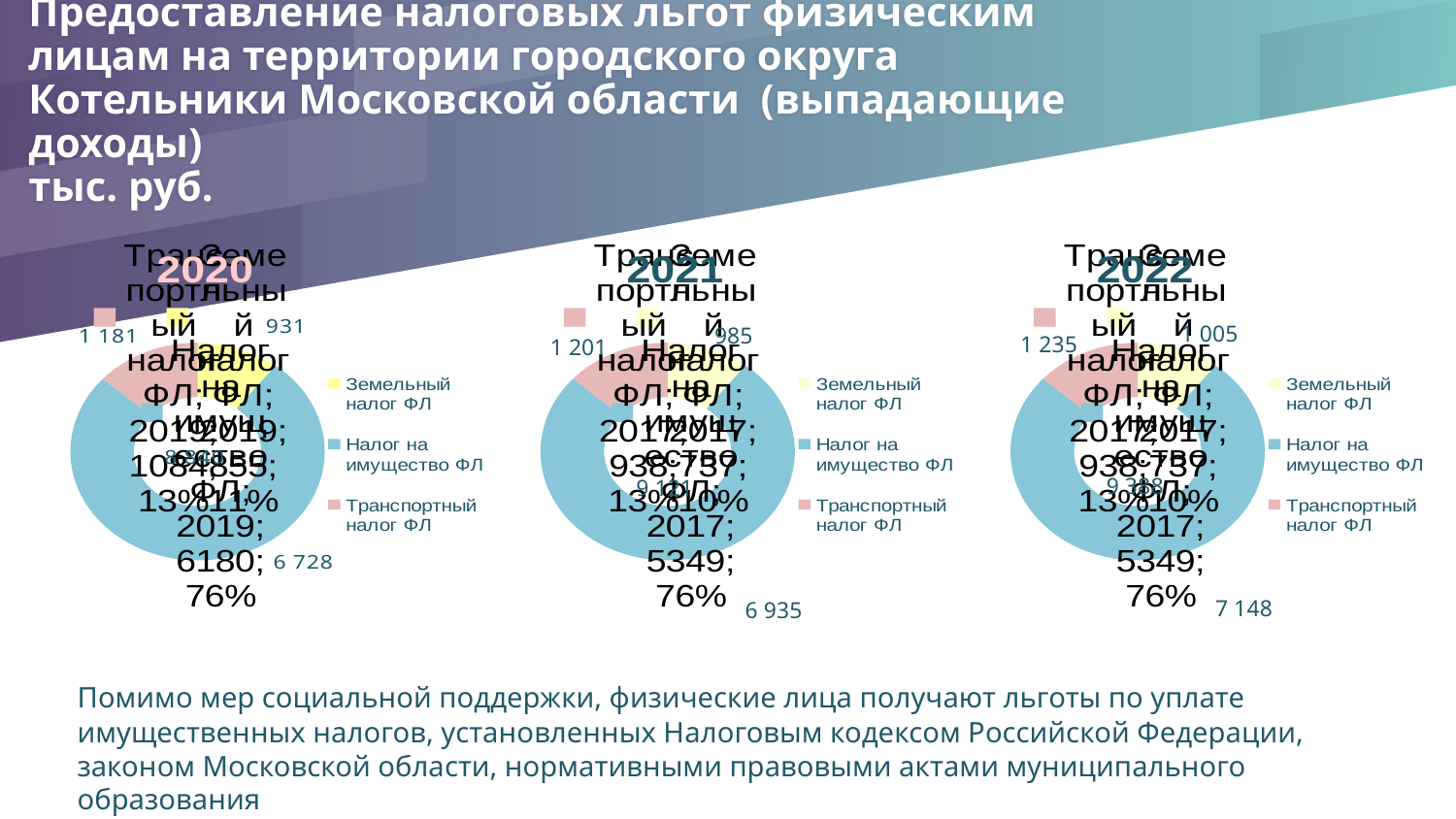
How many series does the legend of the 2020 pie chart list? 3 In the 2022 pie chart, which category has the largest slice? Налог на имущество ФЛ How many pie charts are on the slide? 3 Which colour represents Налог на имущество ФЛ in the pie charts? blue In the 2021 pie chart, which category has the smallest slice? Земельный налог ФЛ What type of chart is used on this slide for each year? doughnut chart In the 2020 pie chart, which is larger: Транспортный налог ФЛ or Земельный налог ФЛ? Транспортный налог ФЛ